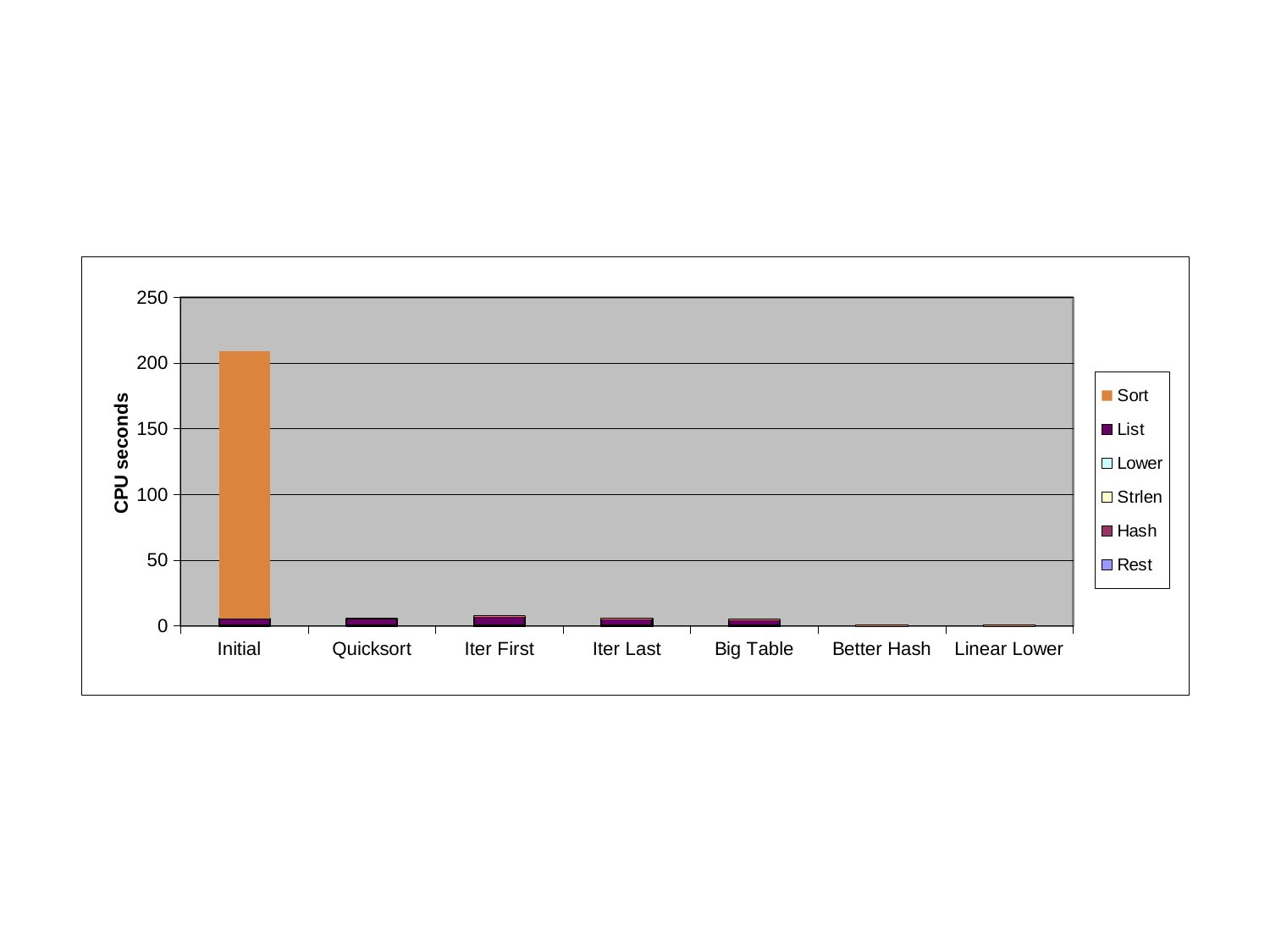
Which category has the highest total CPU seconds? Initial Which series is listed first in the legend? Sort Which is larger, the total for Initial or the total for Quicksort? Initial What is the label on the y axis? CPU seconds Is the total value for Initial greater or less than 200? greater How many series does the legend list? 6 Is the total value for Iter First greater or less than 50? less How many categories are shown on the x axis? 7 What kind of chart is shown on the slide? bar chart Do the bar totals generally rise or fall from left to right along the x axis? fall Which is larger, the total for Iter First or the total for Better Hash? Iter First Is the total value for Quicksort greater or less than 50? less